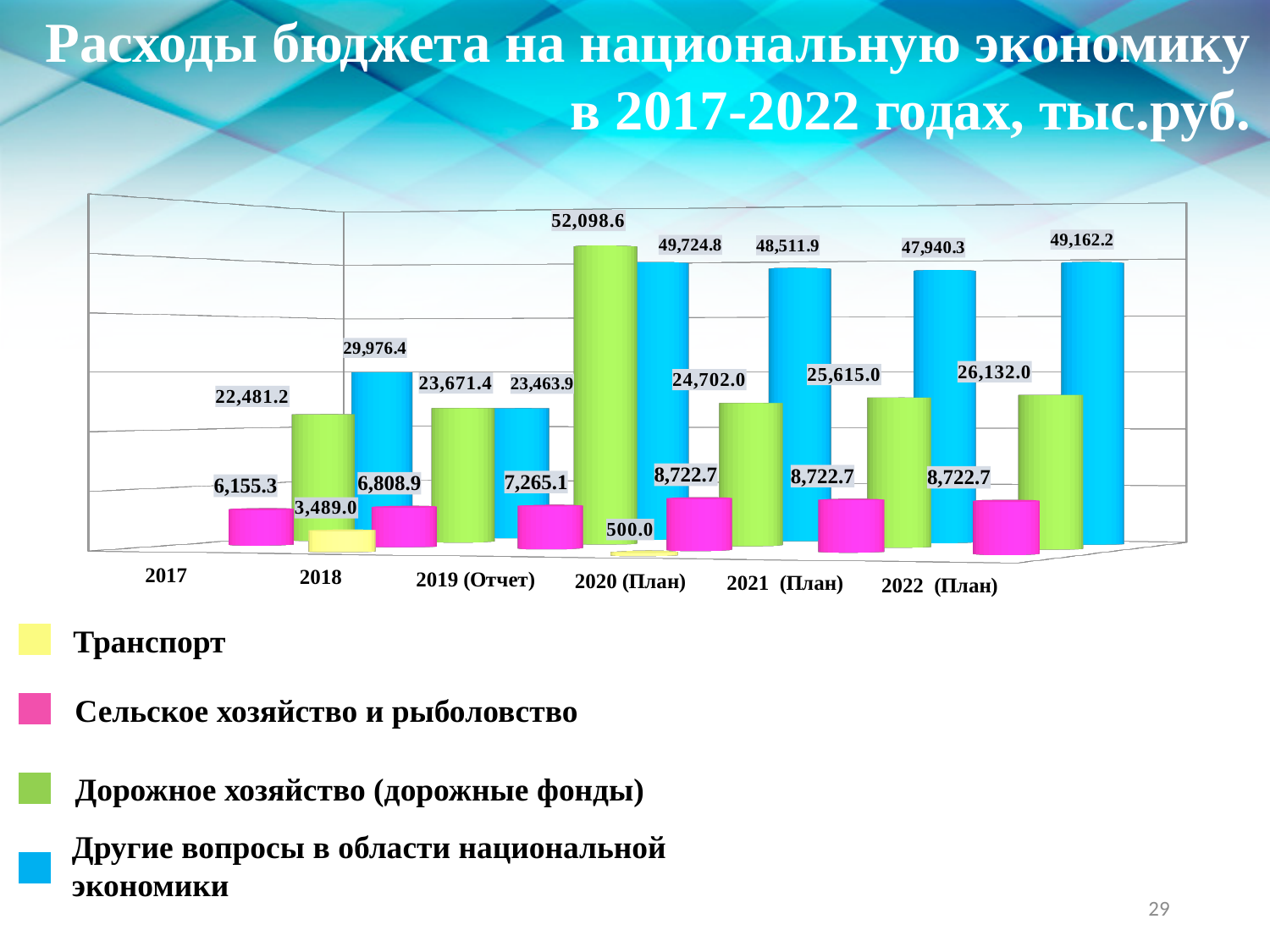
What is the value for Дорожное хозяйство (дорожные фонды) in 2019 (Отчет)? 52,098.6 What is the value for Сельское хозяйство и рыболовство in 2017? 6,155.3 In which year is the value for Дорожное хозяйство (дорожные фонды) the highest? 2019 (Отчет) What is the difference between the values for Другие вопросы в области национальной экономики in 2019 (Отчет) and 2020 (План)? 1,212.9 How many series does the legend list? 4 Does the value for Сельское хозяйство и рыболовство rise or fall from 2017 to 2020 (План)? rise What is the value for Другие вопросы в области национальной экономики in 2022 (План)? 49,162.2 What kind of chart is shown on the slide? bar chart What is the value for Сельское хозяйство и рыболовство in 2021 (План)? 8,722.7 In 2018, which is larger: Дорожное хозяйство (дорожные фонды) or Другие вопросы в области национальной экономики? Дорожное хозяйство (дорожные фонды) How many year categories are shown on the x axis? 6 In which year is the value for Другие вопросы в области национальной экономики the lowest? 2018